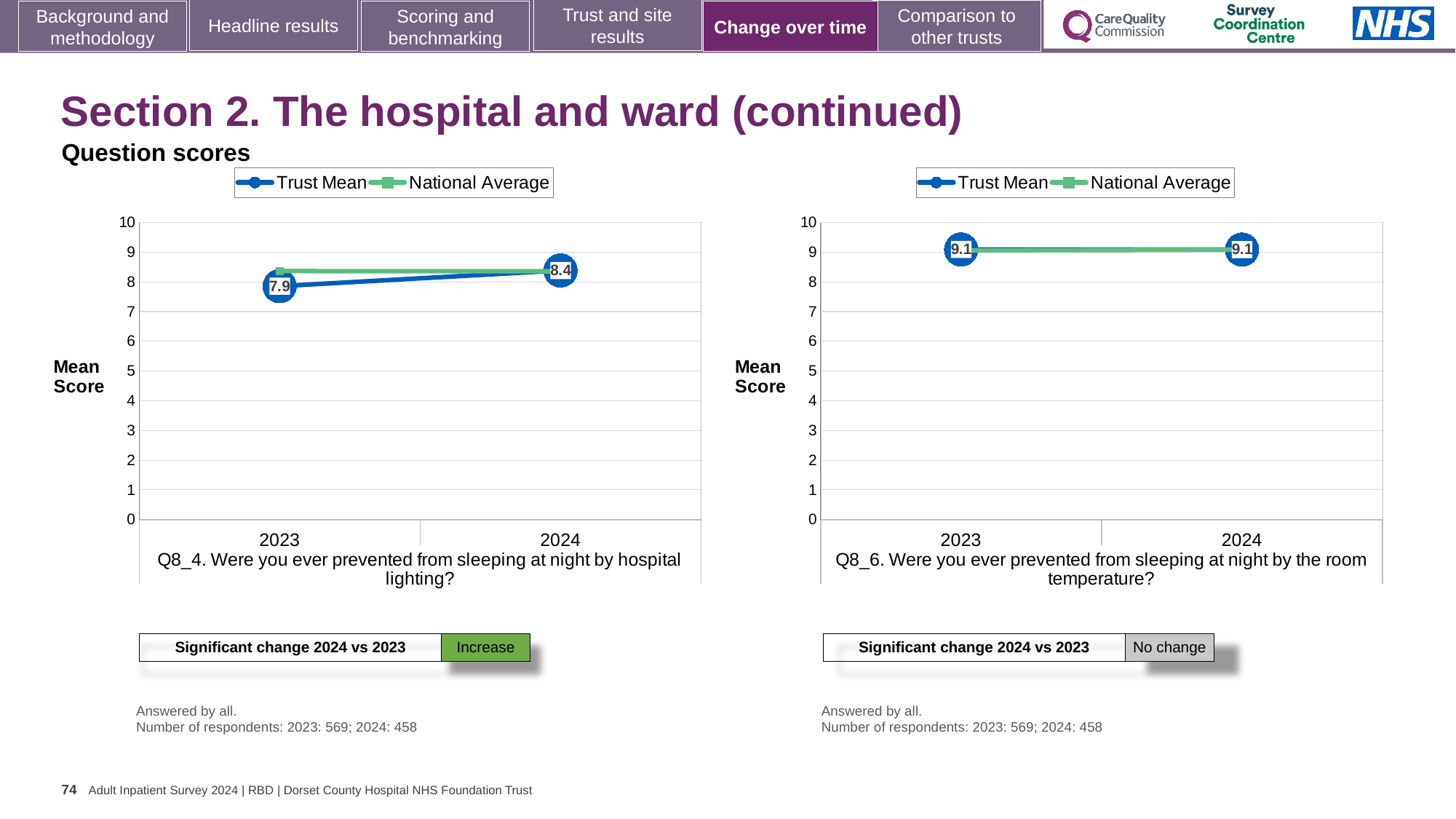
In the left chart (Q8_4, hospital lighting), what is the Trust Mean for 2023? 7.9 In the left chart (Q8_4, hospital lighting), by how much did the Trust Mean change from 2023 to 2024? 0.5 What type of chart is the right chart (Q8_6, room temperature)? line chart How many series does the legend of the left chart list? 2 In the right chart (Q8_6, room temperature), does the Trust Mean rise, fall or stay the same from 2023 to 2024? stay the same In the right chart (Q8_6, room temperature), what is the Trust Mean for 2024? 9.1 In the left chart (Q8_4, hospital lighting), is the National Average for 2023 greater or less than 8? greater In the left chart (Q8_4, hospital lighting), does the Trust Mean rise or fall from 2023 to 2024? rise In the left chart (Q8_4, hospital lighting), what is the Trust Mean for 2024? 8.4 In the left chart (Q8_4, hospital lighting), which year has the higher Trust Mean? 2024 What significant change is reported for the left chart (Q8_4, hospital lighting) for 2024 vs 2023? Increase In the right chart (Q8_6, room temperature), is the National Average for 2024 greater or less than 8? greater